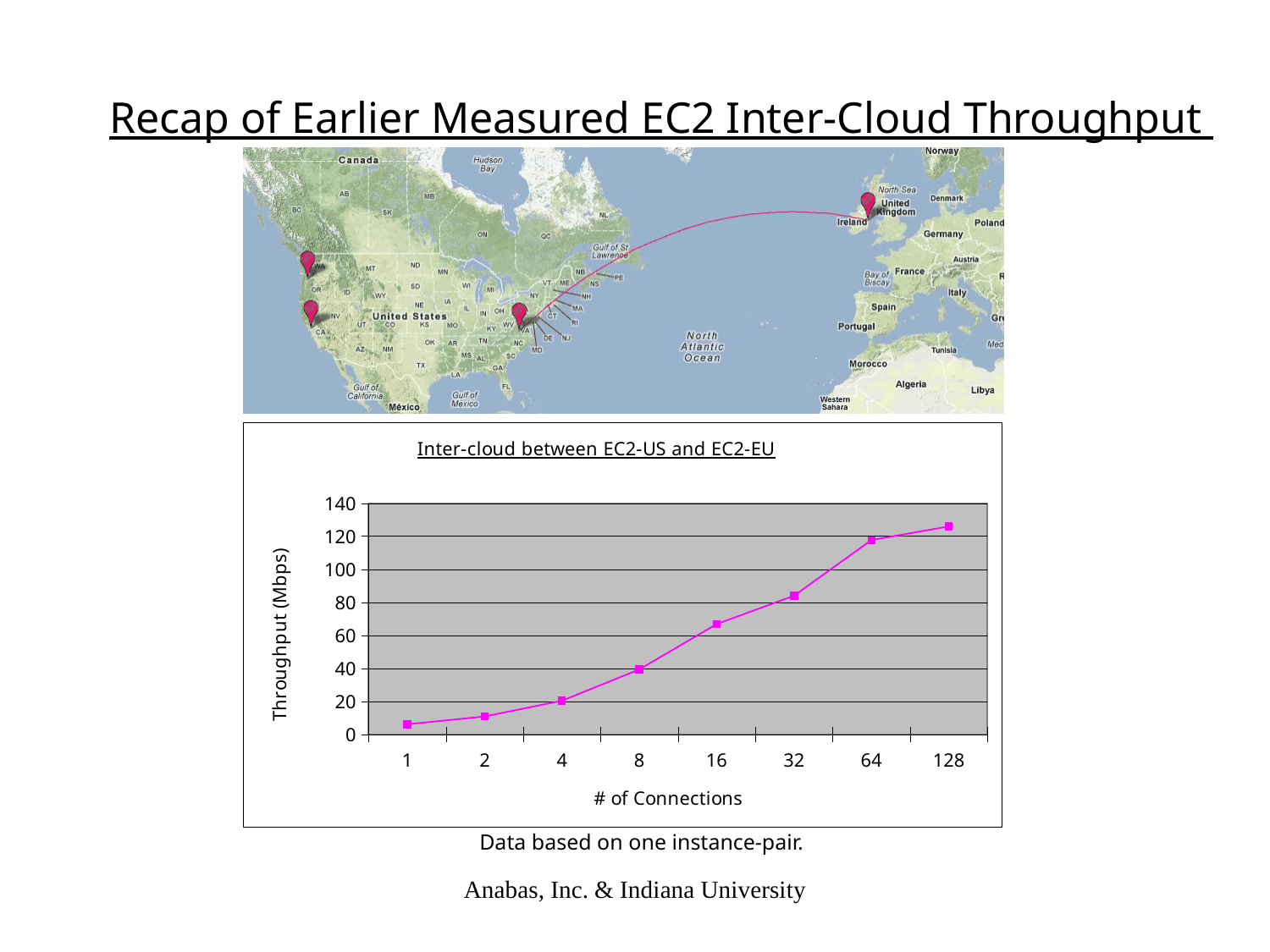
What is the label of the y axis of the chart? Throughput (Mbps) Does the throughput rise or fall as the number of connections increases? rise At which number of connections is the throughput highest? 128 At which number of connections is the throughput lowest? 1 What kind of chart is shown on the slide? line chart How many data points are plotted on the chart? 8 Is the throughput for 16 connections greater or less than 60 Mbps? greater Is the throughput for 64 connections greater or less than 100 Mbps? greater What is the title of the chart? Inter-cloud between EC2-US and EC2-EU Which has the higher throughput, 16 connections or 32 connections? 32 connections Is the throughput for 32 connections greater or less than 100 Mbps? less